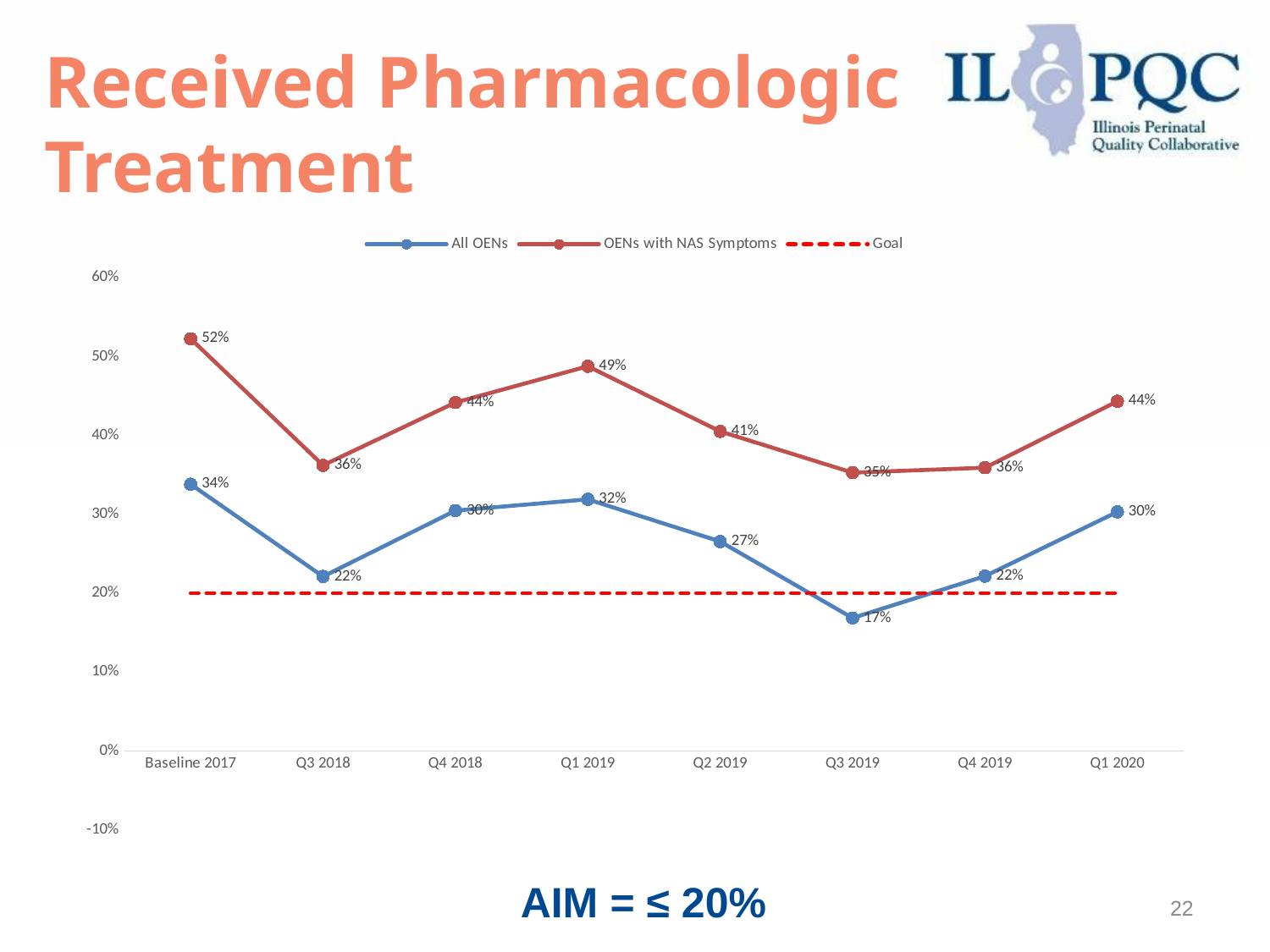
How many series does the legend list? 3 Which is larger at Q2 2019: All OENs or OENs with NAS Symptoms? OENs with NAS Symptoms Does the All OENs series rise or fall from Q3 2019 to Q1 2020? Rise What value does the dashed Goal line sit at? 20% What is the difference between OENs with NAS Symptoms and All OENs at Q1 2020? 14% At which period is the All OENs series lowest? Q3 2019 What is the value for All OENs at Q3 2019? 17% What type of chart is shown on the slide? Line chart What is the value for OENs with NAS Symptoms at Q1 2019? 49% At which period is the OENs with NAS Symptoms series highest? Baseline 2017 How many time periods are shown on the x axis? 8 What is the value for OENs with NAS Symptoms at Baseline 2017? 52%